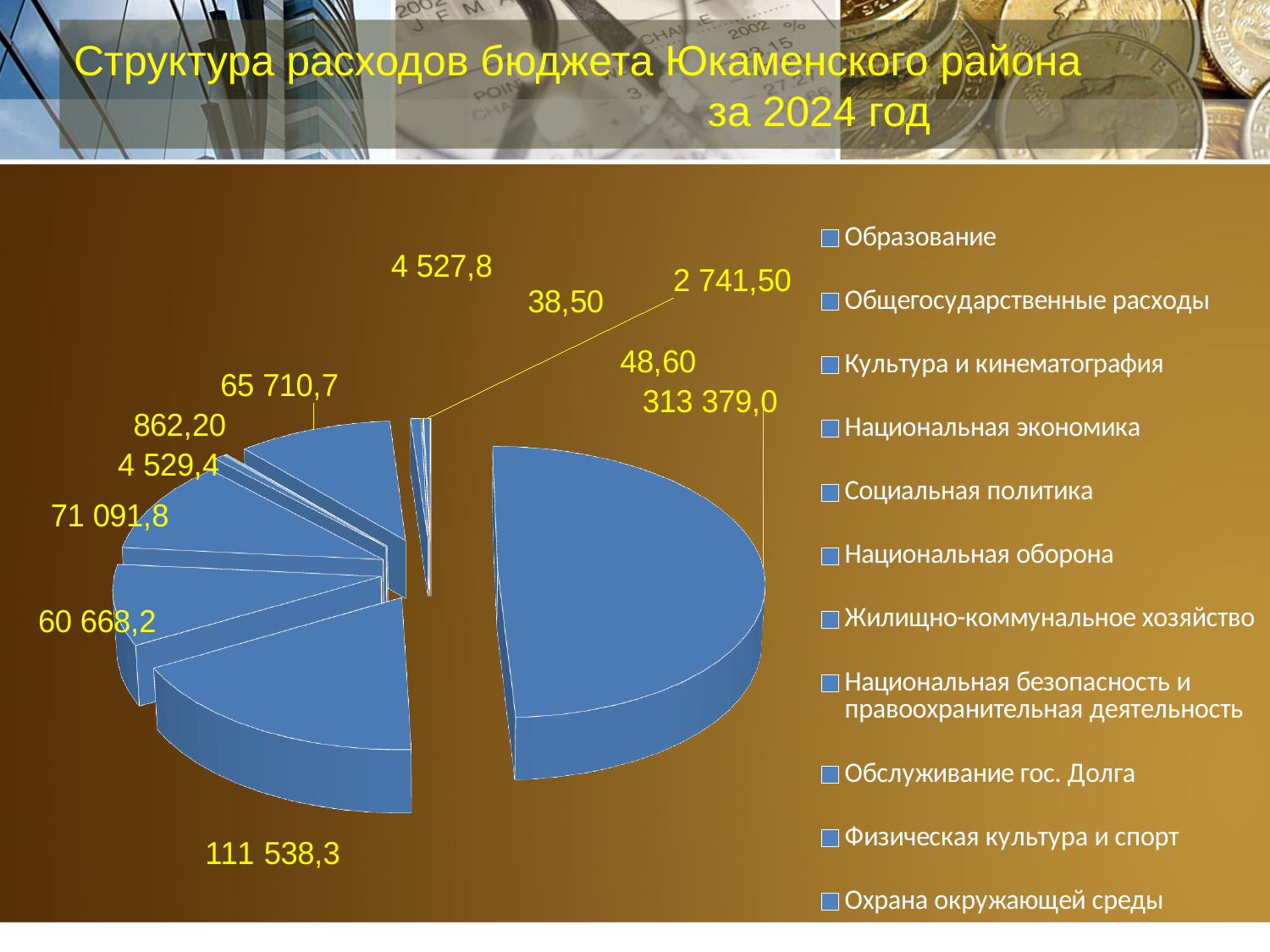
What is the second smallest value labelled on the pie chart? 48,60 How many entries does the legend of the pie chart list? 11 What is the largest value labelled on the pie chart? 313 379,0 What kind of chart is shown on the slide? pie chart Which labelled value is larger on the pie chart: 2 741,50 or 862,20? 2 741,50 What is the first entry listed in the legend of the pie chart? Образование Which labelled value is larger on the pie chart: 71 091,8 or 65 710,7? 71 091,8 How many slices does the pie chart have? 11 What is the difference between the two largest labelled values on the pie chart, 313 379,0 and 111 538,3? 201 840,7 What is the smallest value labelled on the pie chart? 38,50 What is the title of the slide containing the pie chart? Структура расходов бюджета Юкаменского района за 2024 год What is the difference between the labelled values 71 091,8 and 60 668,2? 10 423,6